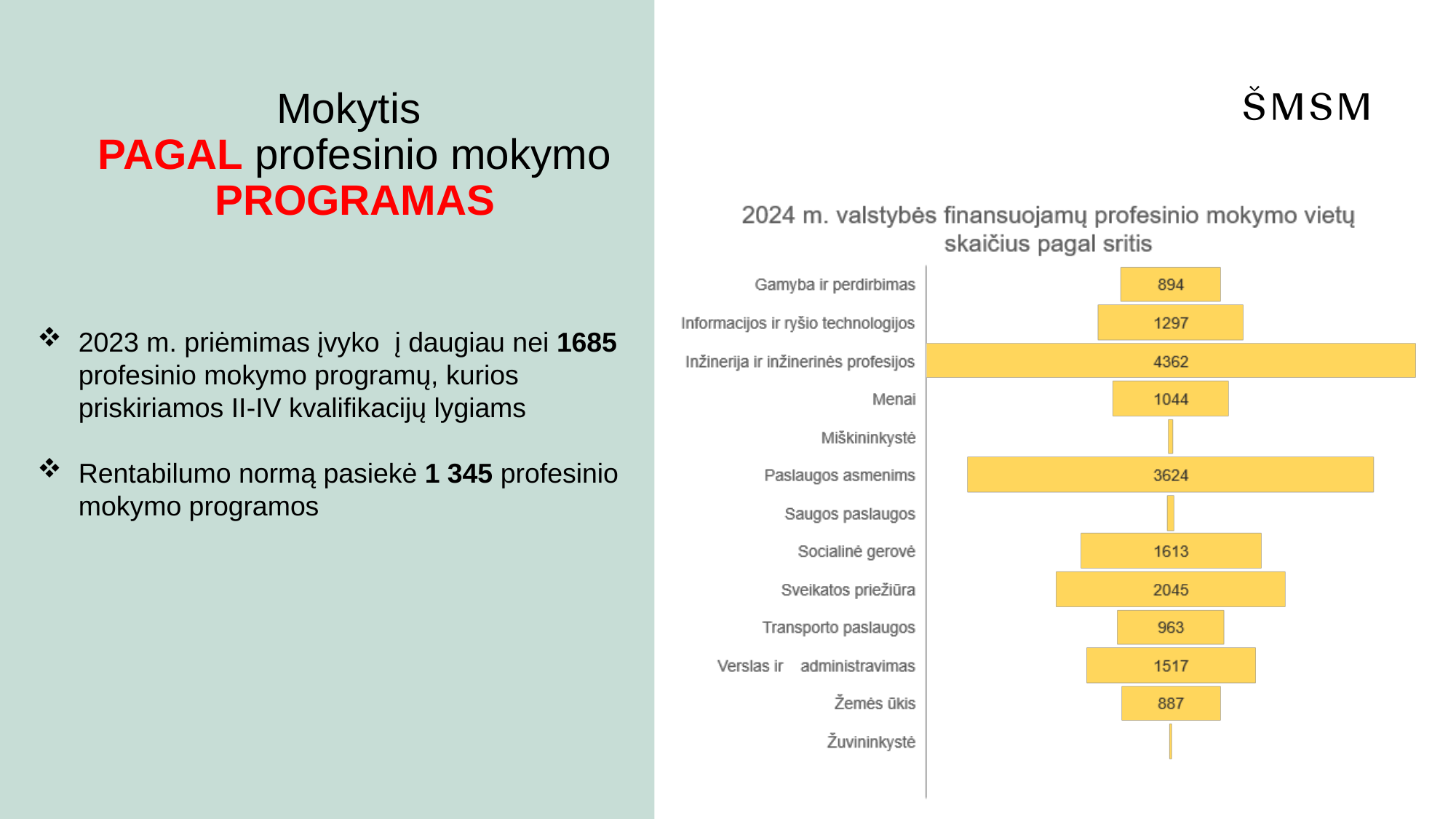
Which is larger, Menai or Transporto paslaugos? Menai Which category has the highest value? Inžinerija ir inžinerinės profesijos What is the value for Žemės ūkis? 887 What is the value for Sveikatos priežiūra? 2045 What kind of chart is shown on the slide? bar chart What is the difference between Inžinerija ir inžinerinės profesijos and Paslaugos asmenims? 738 What is the value for Inžinerija ir inžinerinės profesijos? 4362 What is the title of the chart? 2024 m. valstybės finansuojamų profesinio mokymo vietų skaičius pagal sritis Which is larger, Informacijos ir ryšio technologijos or Verslas ir administravimas? Verslas ir administravimas What is the value for Paslaugos asmenims? 3624 How many categories (sritys) are shown in the chart? 13 What is the difference between Sveikatos priežiūra and Socialinė gerovė? 432